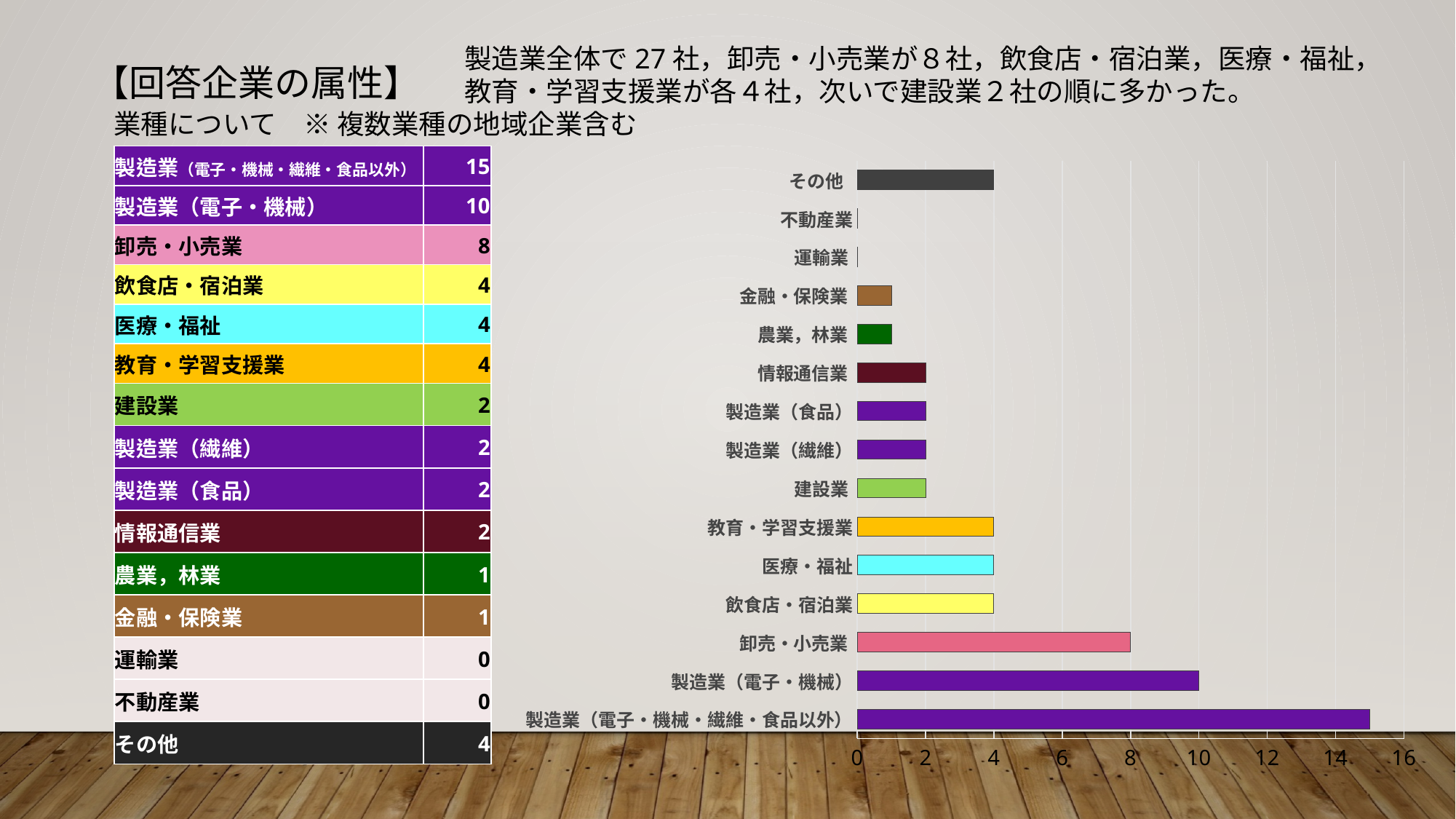
What is the maximum value shown on the x axis? 16 What is the value for 製造業（電子・機械・繊維・食品以外）? 15 Which is larger, 卸売・小売業 or 教育・学習支援業? 卸売・小売業 What is the value for 農業，林業? 1 What kind of chart is shown on the slide? bar chart What is the value for 製造業（電子・機械）? 10 How many categories are plotted in the chart? 15 What is the value for 卸売・小売業? 8 What is the value for 建設業? 2 What is the difference between 製造業（電子・機械・繊維・食品以外） and 製造業（電子・機械）? 5 Which category has the highest value? 製造業（電子・機械・繊維・食品以外） Is the value for 製造業（電子・機械） greater or less than 8? greater